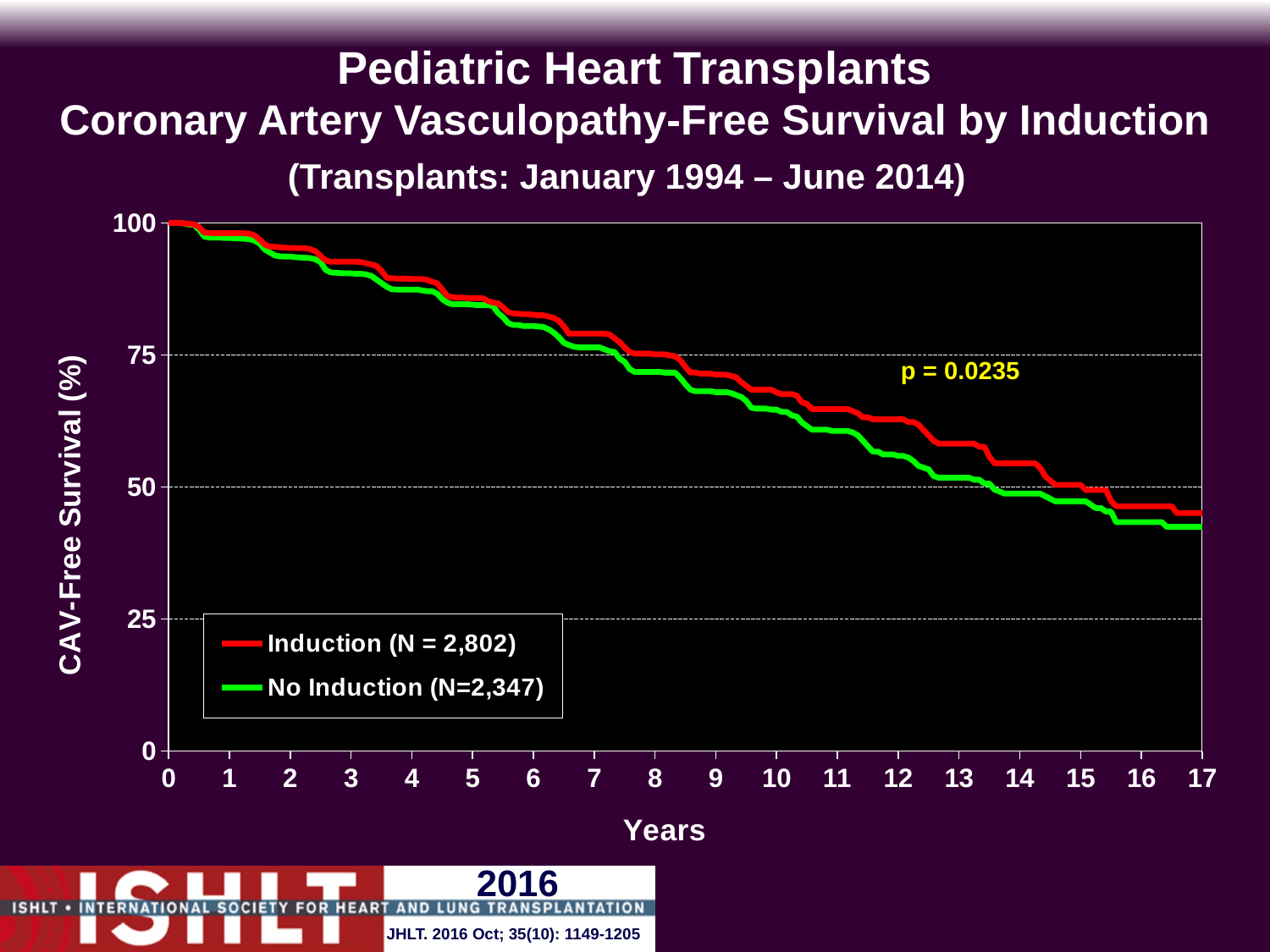
How many series does the legend list? 2 Which series has the higher CAV-free survival at year 10, Induction or No Induction? Induction Is the CAV-free survival for the Induction group at year 17 greater or less than 50? less Is the CAV-free survival for the No Induction group at year 8 greater or less than 75? less Do the CAV-free survival values rise or fall as the years increase? Fall Is the CAV-free survival for the Induction group at year 5 greater or less than 75? greater What kind of chart is shown on the slide? Line chart Which series has the higher CAV-free survival at year 13, Induction or No Induction? Induction What p-value is shown on the chart? p = 0.0235 What is the N for the Induction group shown in the legend? 2,802